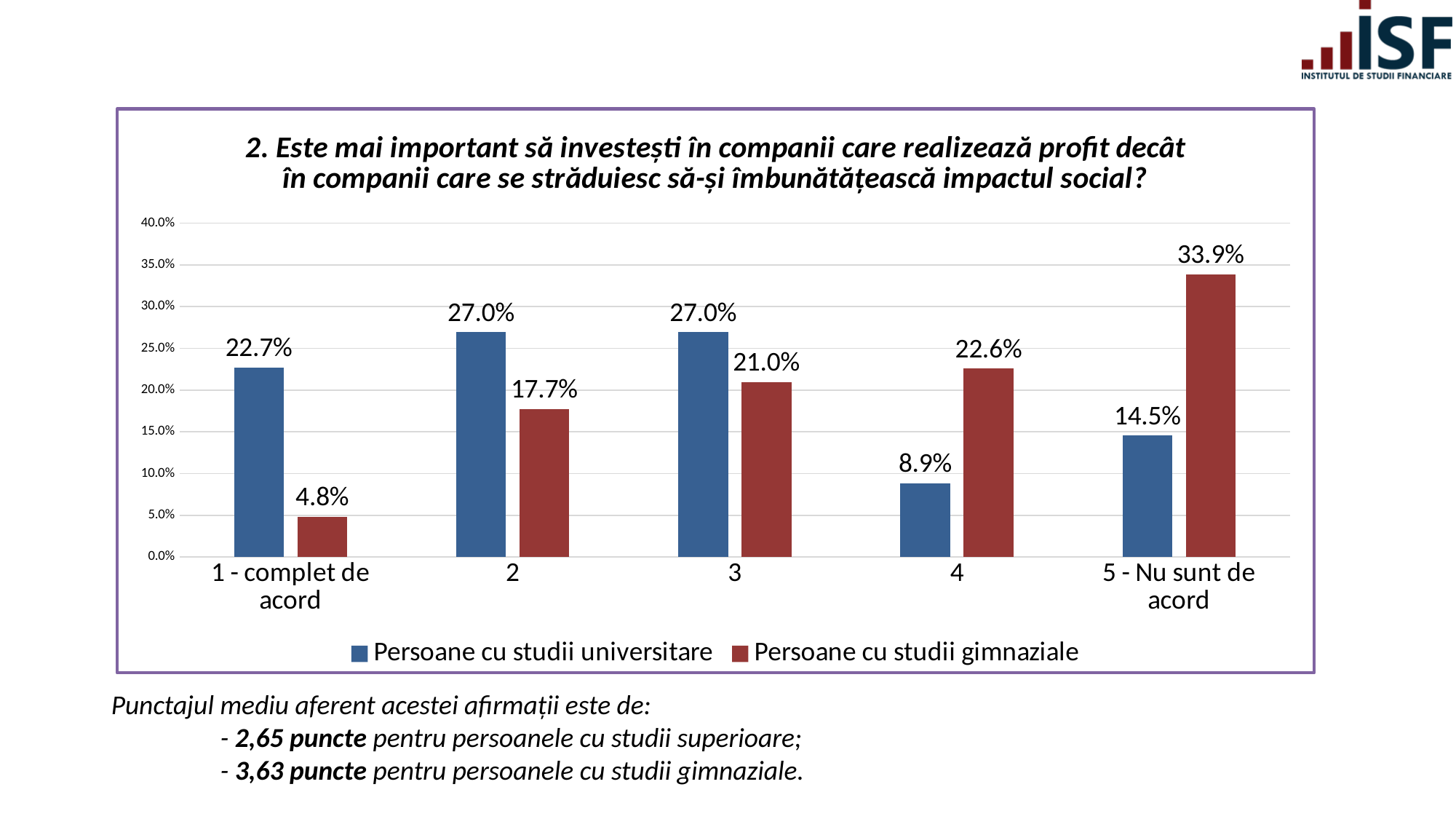
What is the value for 'Persoane cu studii gimnaziale' at category '5 - Nu sunt de acord'? 33.9% Which category has the lowest value for 'Persoane cu studii universitare'? 4 Which colour represents 'Persoane cu studii gimnaziale' in the chart? Red How many series does the legend list? 2 Which category has the lowest value for 'Persoane cu studii gimnaziale'? 1 - complet de acord How many categories are shown on the x axis? 5 What is the value for 'Persoane cu studii universitare' at category '1 - complet de acord'? 22.7% At category 2, which series has the larger value: 'Persoane cu studii universitare' or 'Persoane cu studii gimnaziale'? Persoane cu studii universitare Which category has the highest value for 'Persoane cu studii gimnaziale'? 5 - Nu sunt de acord What kind of chart is shown on the slide? Bar chart What is the difference between 'Persoane cu studii gimnaziale' and 'Persoane cu studii universitare' at category '5 - Nu sunt de acord'? 19.4% What is the value for 'Persoane cu studii gimnaziale' at category 4? 22.6%